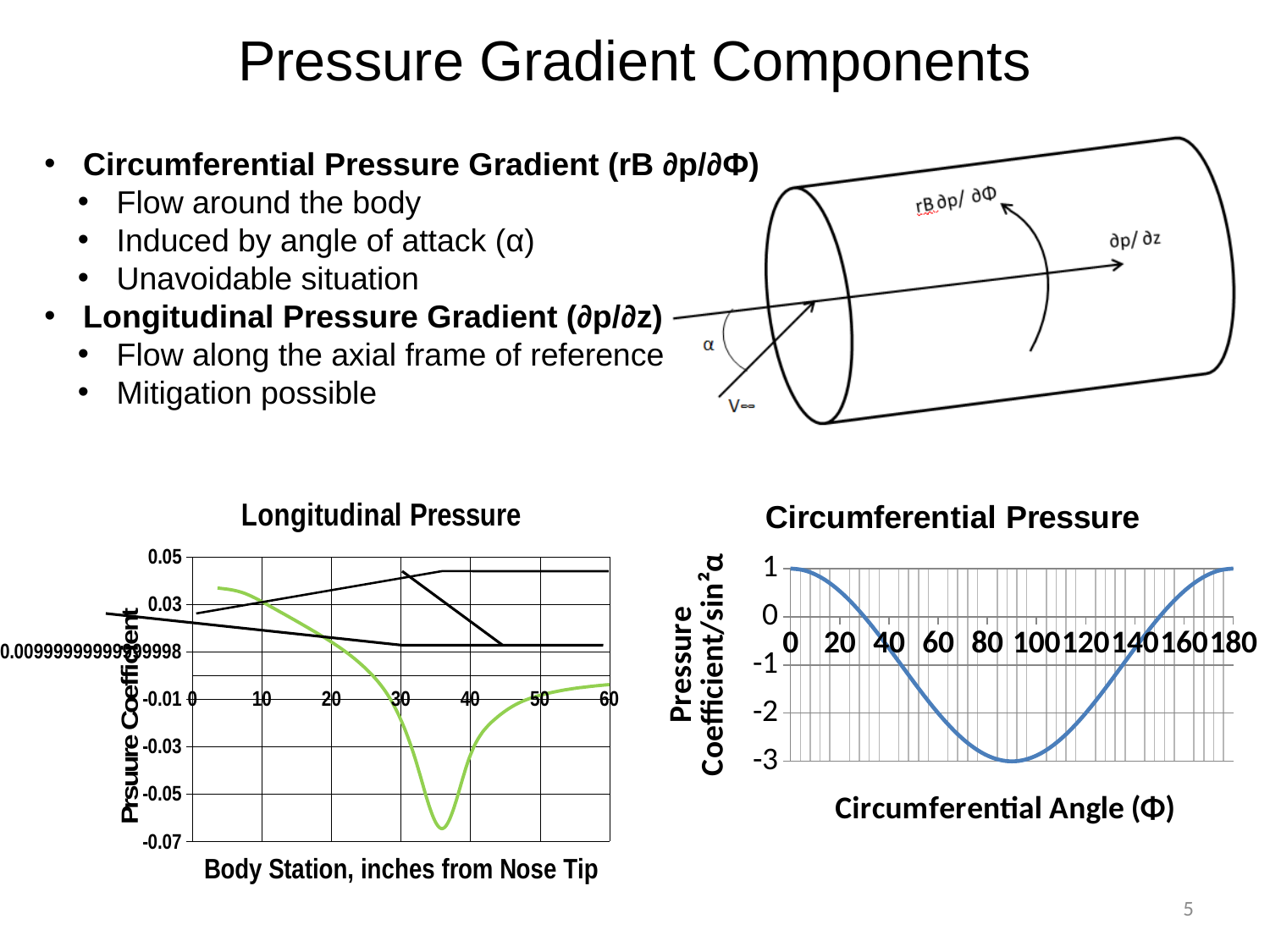
In the Circumferential Pressure chart, what is the value of Pressure Coefficient/sin²α at a circumferential angle of 90? -3 In the Longitudinal Pressure chart, is the lowest value of the green curve greater or less than -0.05? less What kind of chart is the Circumferential Pressure chart? line chart In the Circumferential Pressure chart, is the value at a circumferential angle of 60 greater or less than 0? less In the Circumferential Pressure chart, is the value at a circumferential angle of 20 greater or less than 0? greater In the Circumferential Pressure chart, at which circumferential angle does the curve reach its lowest value? 90 In the Circumferential Pressure chart, what is the value of Pressure Coefficient/sin²α at a circumferential angle of 180? 1 In the Circumferential Pressure chart, what is the value of Pressure Coefficient/sin²α at a circumferential angle of 0? 1 What kind of chart is the Longitudinal Pressure chart? line chart What is the x-axis title of the Longitudinal Pressure chart? Body Station, inches from Nose Tip In the Circumferential Pressure chart, does the curve rise or fall as the angle goes from 0 to 90? fall In the Longitudinal Pressure chart, between which two x-axis ticks does the green curve reach its minimum? 30 and 40